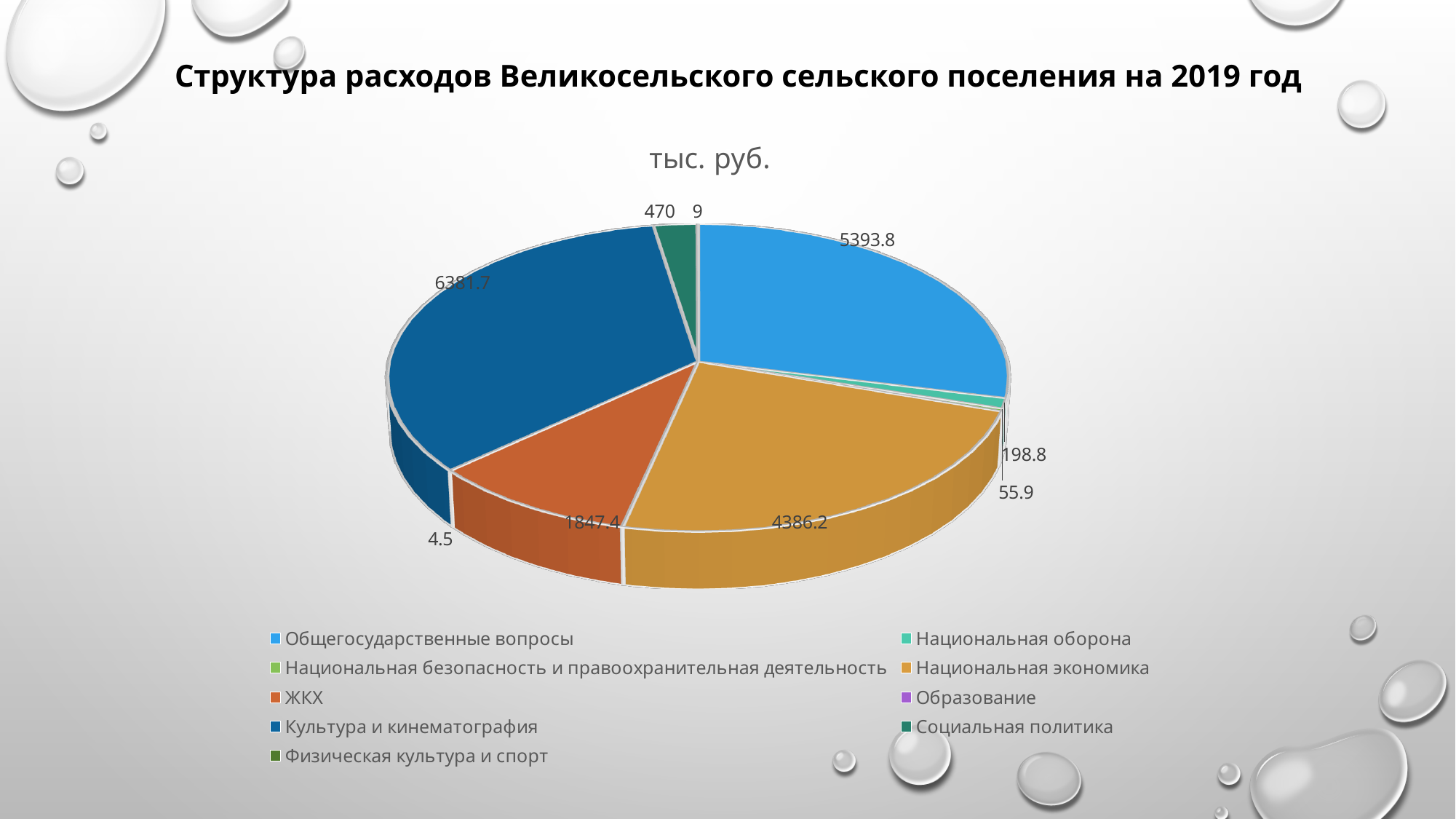
What is the value for Общегосударственные вопросы? 5393.8 What is the value for Национальная экономика? 4386.2 Which category has the smallest value? Образование Which is larger, the value for Национальная экономика or the value for ЖКХ? Национальная экономика What is the difference between the values for Культура и кинематография and Общегосударственные вопросы? 987.9 What is the value for Культура и кинематография? 6381.7 What is the value for ЖКХ? 1847.4 What unit is given in the chart title? тыс. руб. How many categories does the legend list? 9 What is the value for Социальная политика? 470 Which category has the largest value? Культура и кинематография What type of chart is shown on the slide? Pie chart